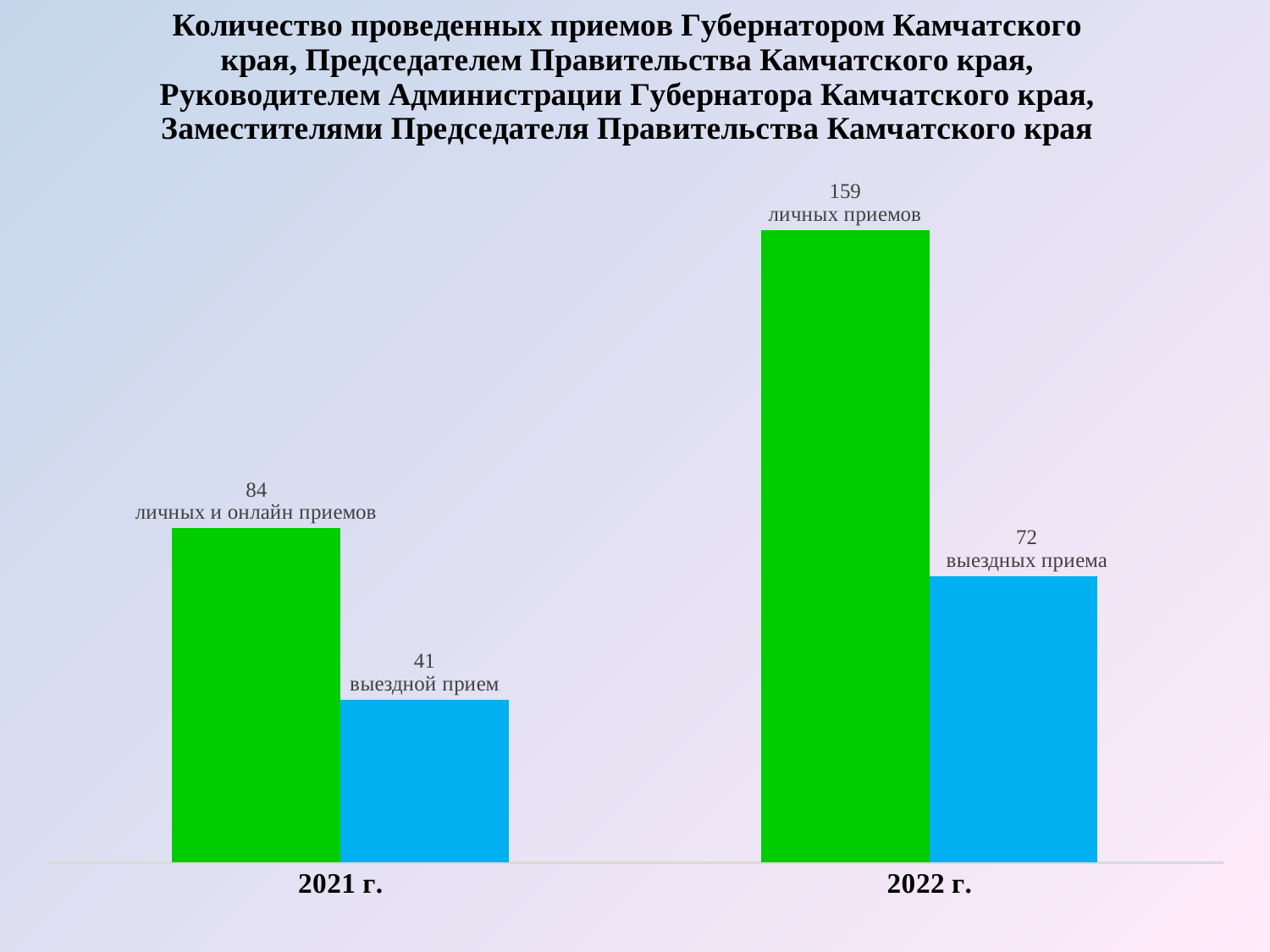
Which bar has the highest value on the chart? 159 личных приемов (2022 г.) What kind of chart is shown on the slide? Bar chart What is the difference between the number of on-site receptions in 2022 г. and in 2021 г.? 31 Which bar has the lowest value on the chart? 41 выездной прием (2021 г.) Which is larger: the number of on-site receptions in 2022 г. or the number of personal and online receptions in 2021 г.? Personal and online receptions in 2021 г. (84) How many year categories are shown on the x axis? 2 How many personal receptions (личных приемов) were held in 2022 г.? 159 How many on-site receptions (выездной прием) were held in 2021 г.? 41 What is the difference between the number of personal receptions in 2022 г. and the number of personal and online receptions in 2021 г.? 75 What colour are the bars representing on-site receptions (выездные приемы)? Blue How many personal and online receptions (личных и онлайн приемов) were held in 2021 г.? 84 How many on-site receptions (выездных приема) were held in 2022 г.? 72